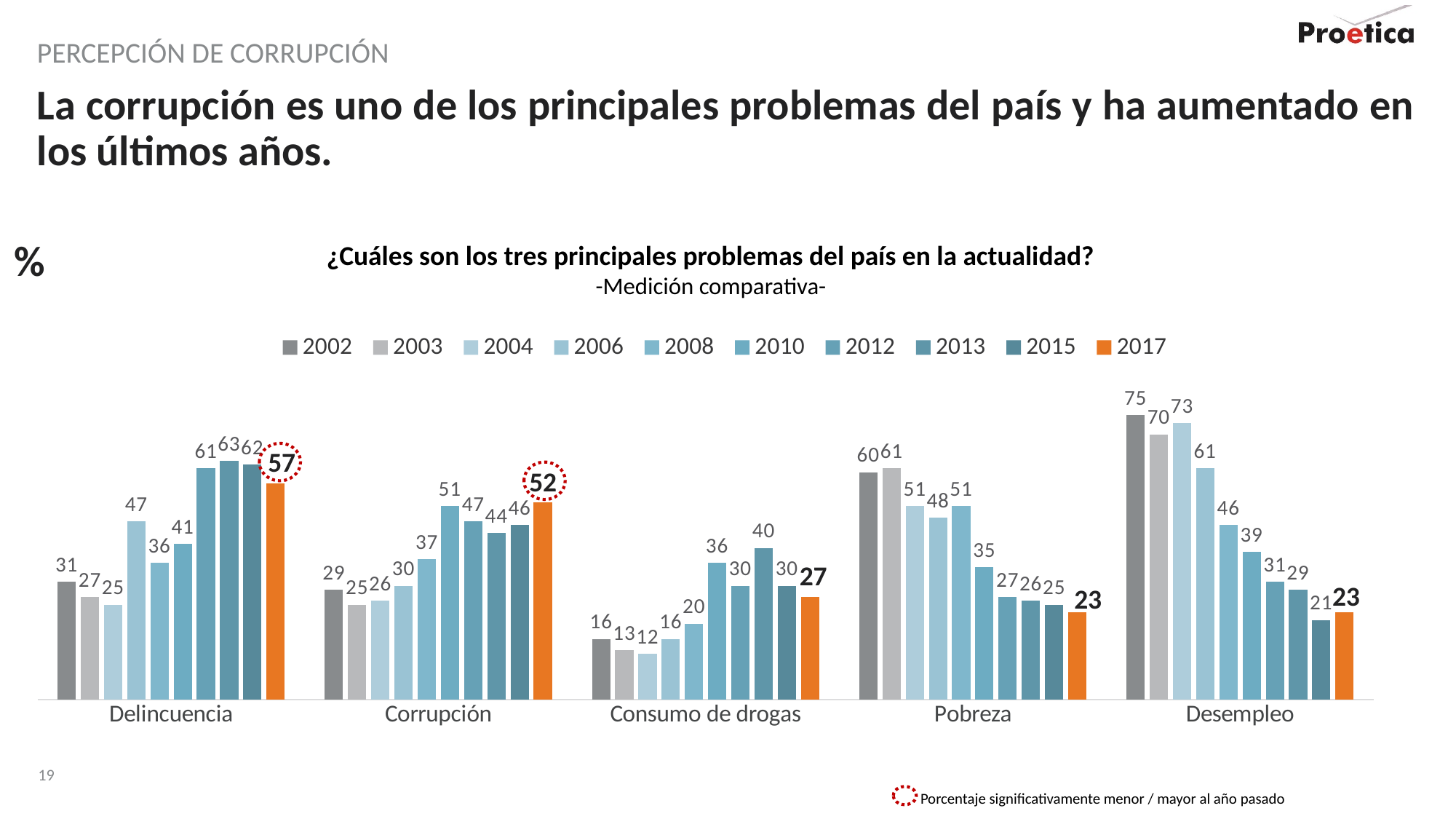
What is the difference between the 2002 and 2017 values for Desempleo? 52 What is the value for Corrupción in 2017? 52 Which is larger for 2017: the value for Delincuencia or the value for Corrupción? Delincuencia How many years does the legend list? 10 What is the value for Desempleo in 2002? 75 How many problem categories are shown on the x axis? 5 Which series is shown in orange in the legend? 2017 Which year has the highest value for Delincuencia? 2013 Which year has the lowest value for Pobreza? 2017 What is the value for Consumo de drogas in 2013? 40 Do the values for Pobreza rise or fall from 2003 to 2017? Fall What kind of chart is shown on the slide? Bar chart